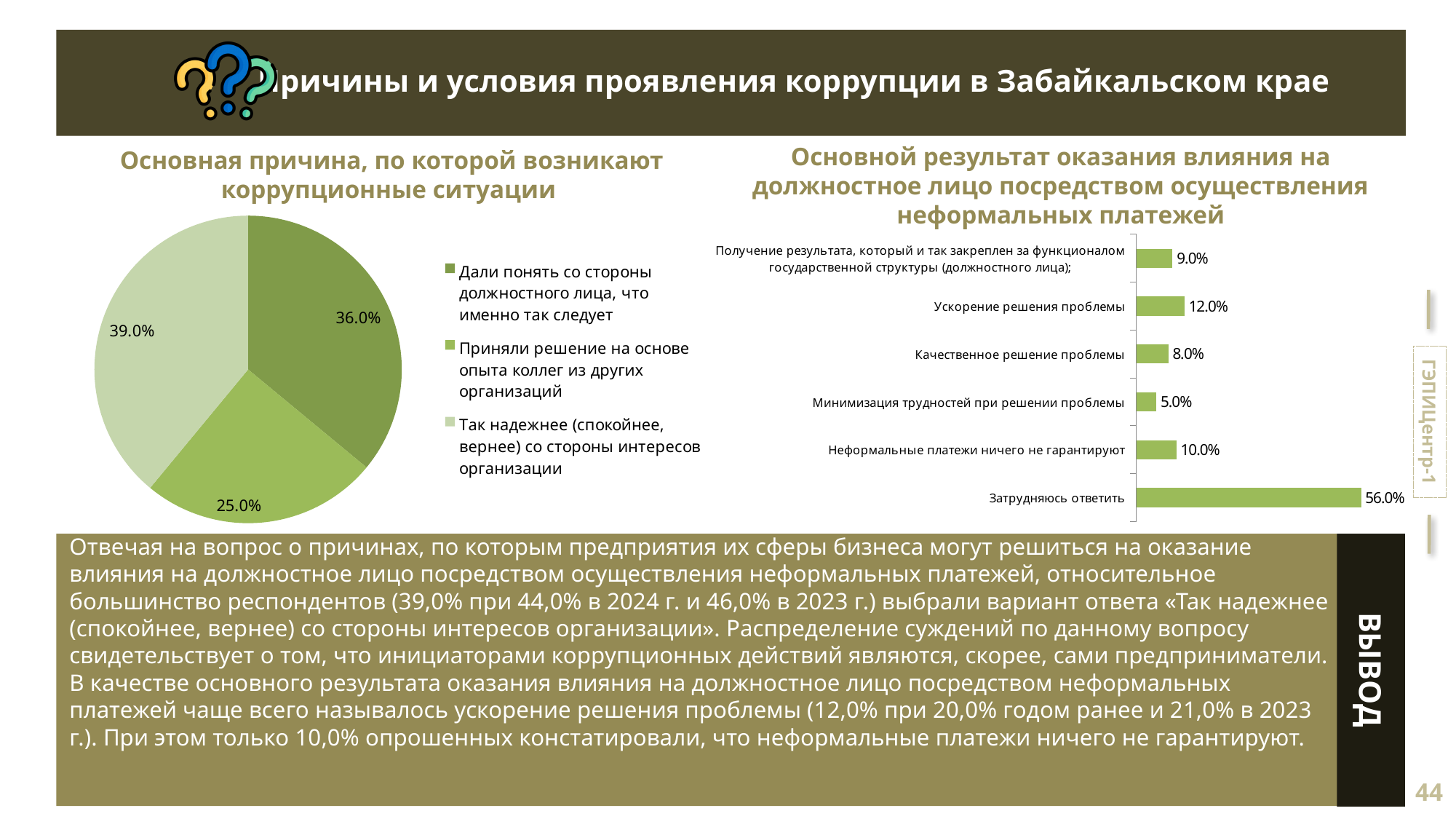
In the pie chart on the left, which category has the smallest share? Приняли решение на основе опыта коллег из других организаций What type of chart is the chart on the right, 'Основной результат оказания влияния на должностное лицо посредством осуществления неформальных платежей'? Bar chart In the bar chart on the right, what is the value for 'Ускорение решения проблемы'? 12.0% In the pie chart on the left, what is the difference between the shares for 'Дали понять со стороны должностного лица, что именно так следует' and 'Приняли решение на основе опыта коллег из других организаций'? 11.0% In the bar chart on the right, which category has the highest value? Затрудняюсь ответить In the pie chart on the left, what share is shown for 'Приняли решение на основе опыта коллег из других организаций'? 25.0% In the bar chart on the right, what is the value for 'Неформальные платежи ничего не гарантируют'? 10.0% In the bar chart on the right, which category has the lowest value? Минимизация трудностей при решении проблемы In the pie chart 'Основная причина, по которой возникают коррупционные ситуации', what share is shown for 'Так надежнее (спокойнее, вернее) со стороны интересов организации'? 39.0% In the pie chart on the left, which category has the largest share? Так надежнее (спокойнее, вернее) со стороны интересов организации How many entries does the legend of the pie chart on the left list? 3 In the bar chart on the right, how many categories are shown? 6